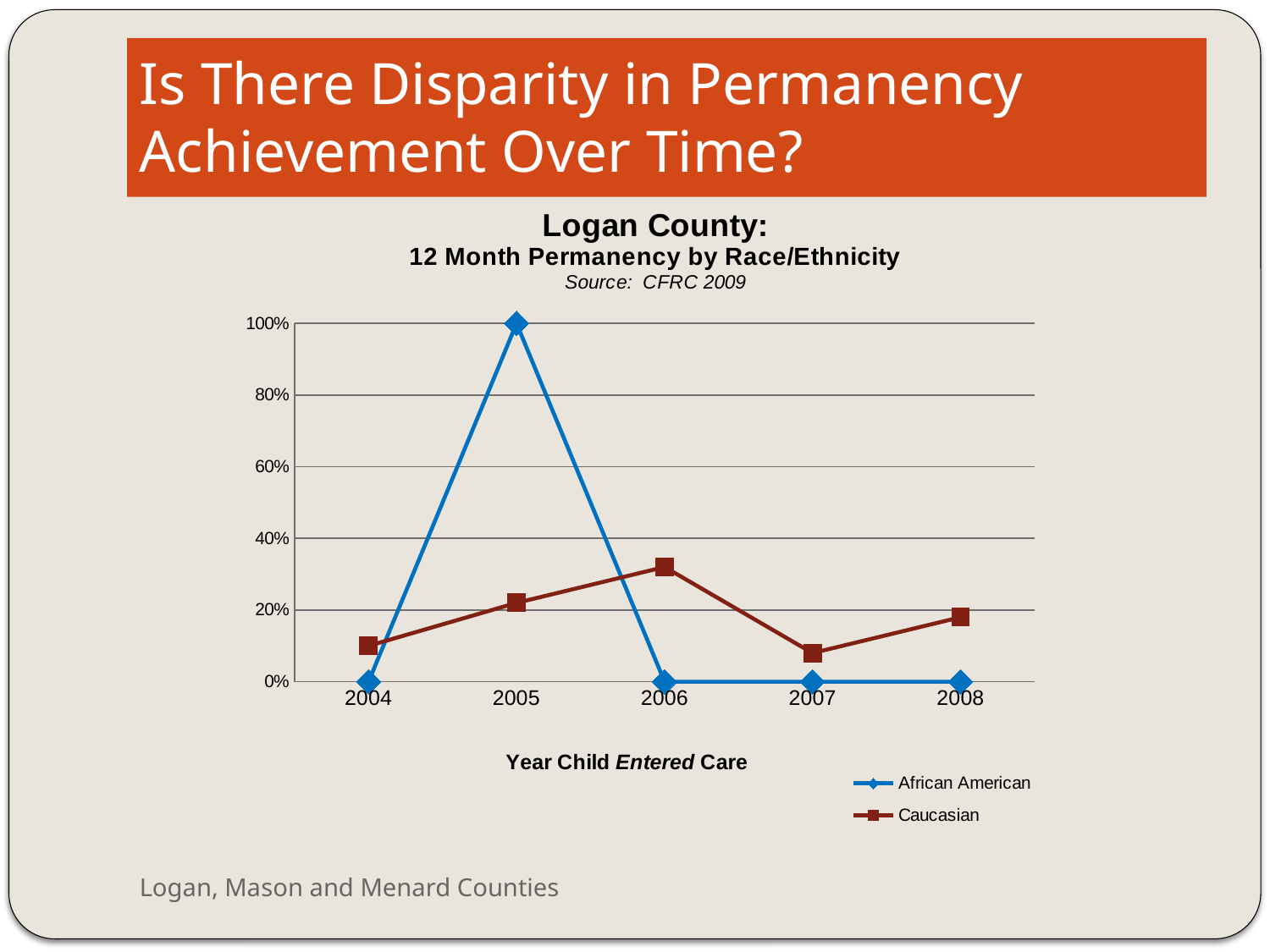
In which year is the Caucasian series at its lowest? 2007 Which series has the larger value in 2005, African American or Caucasian? African American Is the Caucasian value for 2007 greater or less than 20%? less What is the source cited under the chart title? CFRC 2009 How many years are plotted along the x axis? 5 What is the 12 month permanency value for African American children who entered care in 2006? 0% What kind of chart is shown on the slide? line chart In which year is the African American series at its highest? 2005 In which year is the Caucasian series at its highest? 2006 What is the 12 month permanency value for African American children who entered care in 2005? 100% How many series does the legend list? 2 Is the Caucasian value for 2006 greater or less than 20%? greater